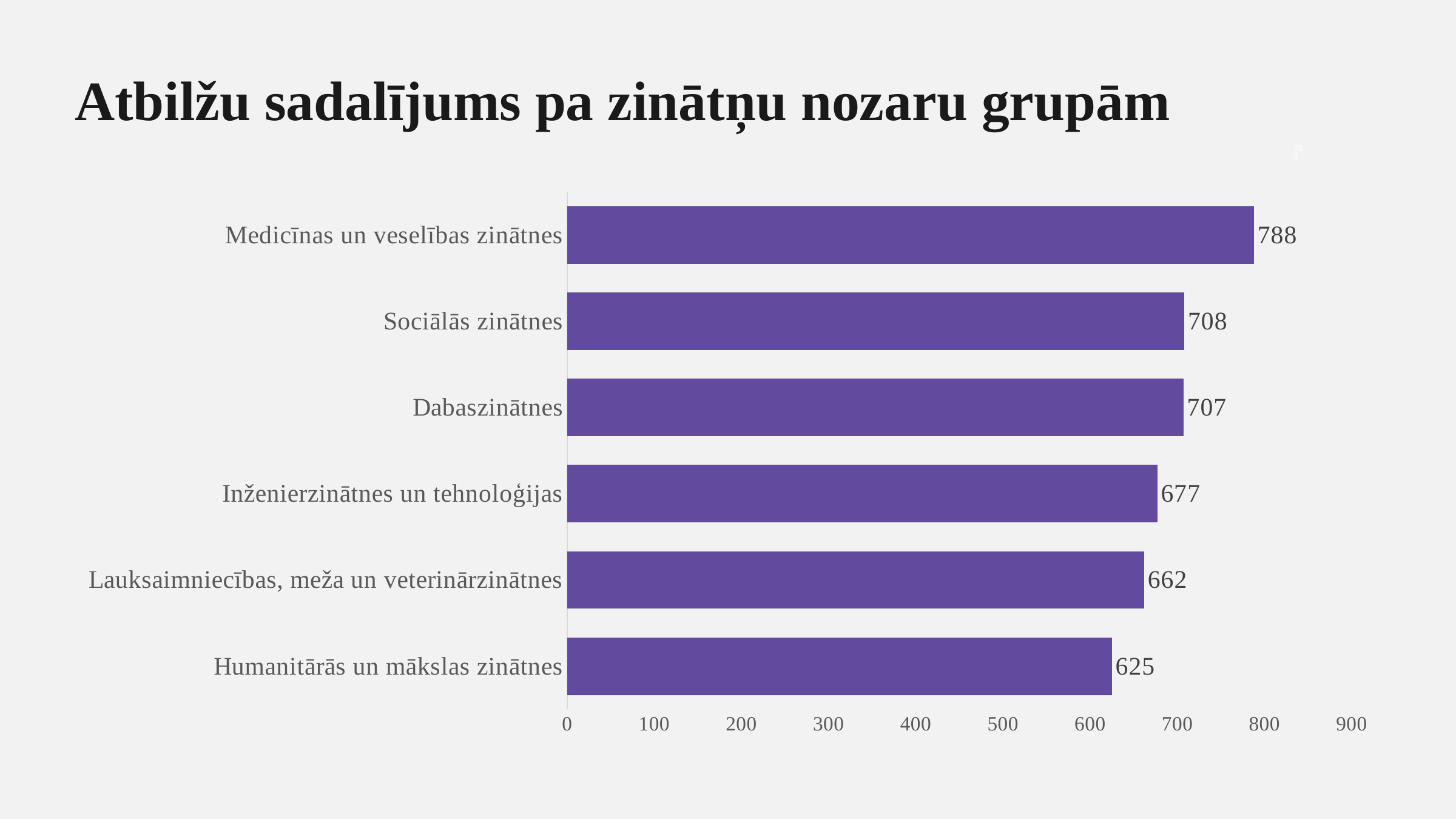
What is the value for Sociālās zinātnes? 708 What is the value for Medicīnas un veselības zinātnes? 788 What is the value for Humanitārās un mākslas zinātnes? 625 What is the difference between the values for Medicīnas un veselības zinātnes and Humanitārās un mākslas zinātnes? 163 Which category has the lowest value? Humanitārās un mākslas zinātnes What is the difference between the values for Inženierzinātnes un tehnoloģijas and Lauksaimniecības, meža un veterinārzinātnes? 15 Which category has the highest value? Medicīnas un veselības zinātnes What is the value for Inženierzinātnes un tehnoloģijas? 677 Is the value for Sociālās zinātnes greater or less than 700? greater What kind of chart is shown on the slide? bar chart How many categories are shown in the chart? 6 Which is larger, the value for Dabaszinātnes or the value for Lauksaimniecības, meža un veterinārzinātnes? Dabaszinātnes